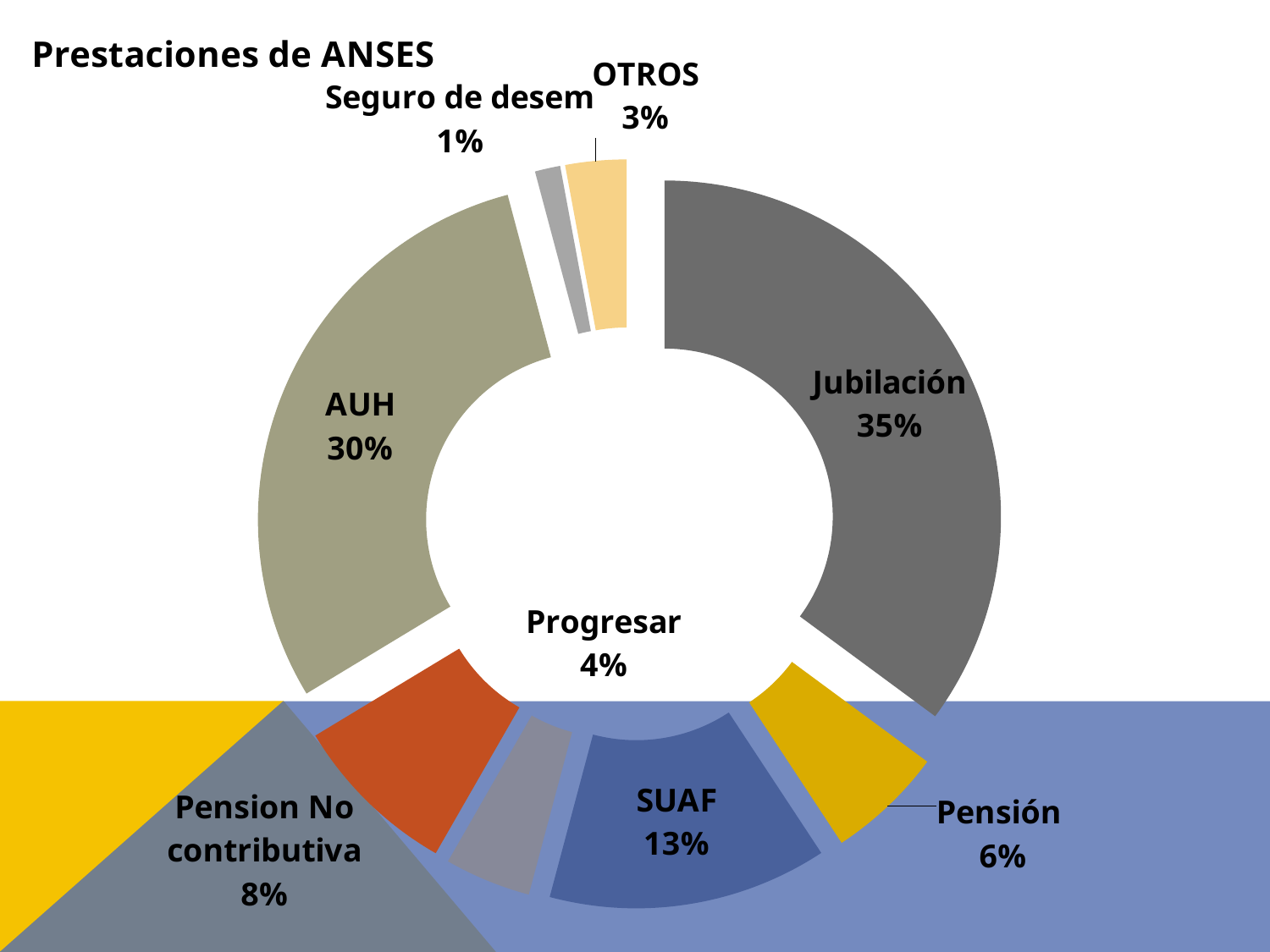
What share does Jubilación have in the chart? 35% What is the combined share of SUAF and Pensión? 19% Which category has the largest share in the chart? Jubilación What is the title of the chart? Prestaciones de ANSES What kind of chart is shown on the slide? Doughnut (pie) chart Which is larger, the share for Pensión or the share for Progresar? Pensión Which category has the smallest share in the chart? Seguro de desem What is the difference in percentage points between Jubilación and AUH? 5 percentage points What share does AUH have in the chart? 30% What share does Pension No contributiva have in the chart? 8% What share does SUAF have in the chart? 13% How many categories are shown in the chart? 8